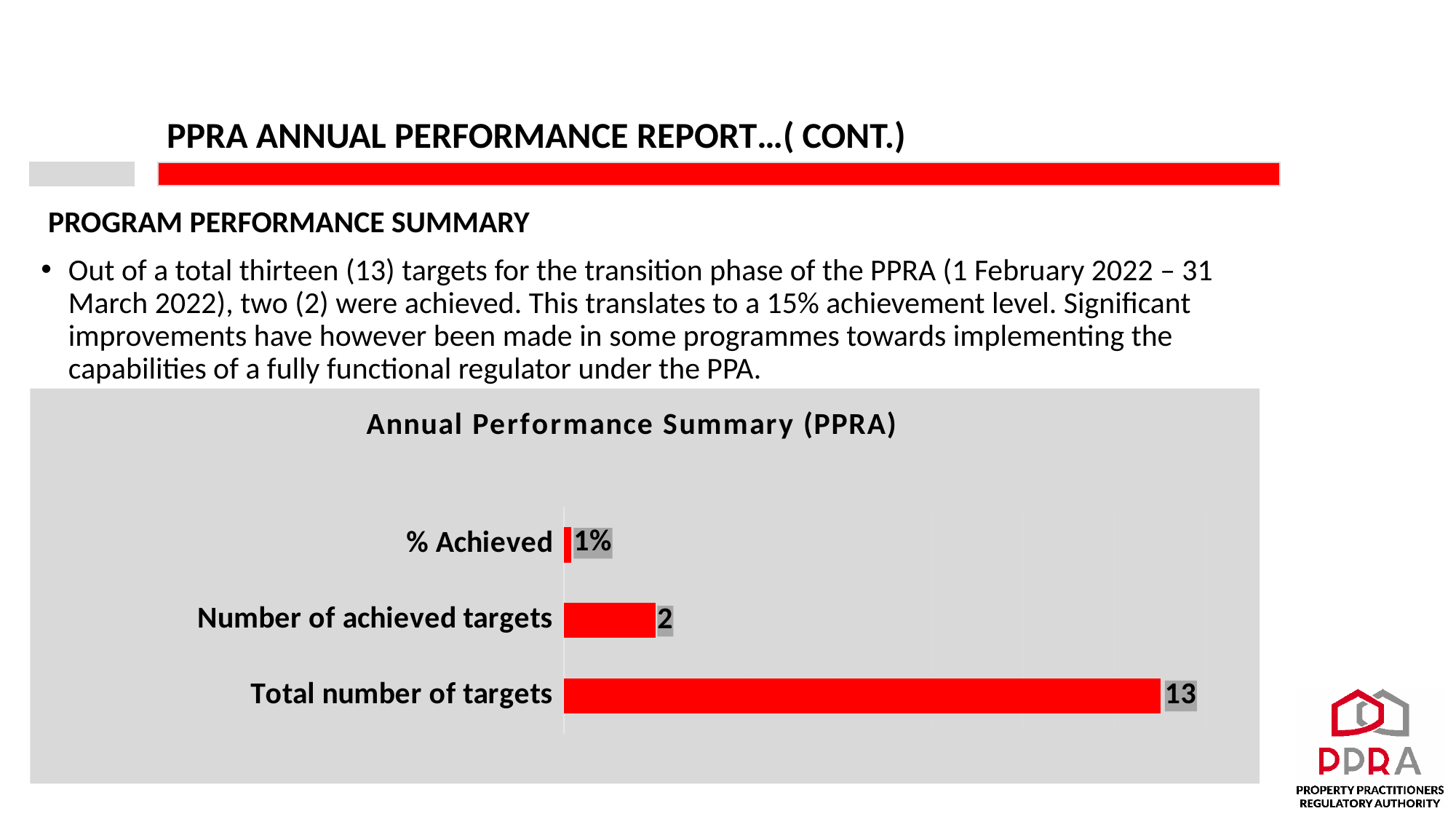
What is the value for Number of achieved targets in the chart? 2 Which is larger, Total number of targets or Number of achieved targets? Total number of targets What kind of chart is the Annual Performance Summary (PPRA)? Bar chart What is the value for Total number of targets in the Annual Performance Summary (PPRA) chart? 13 What data label is shown for % Achieved in the chart? 1% What is the title of the chart on the slide? Annual Performance Summary (PPRA) What is the difference between Total number of targets and Number of achieved targets? 11 Which category has the lowest value in the chart? % Achieved How many categories are shown in the Annual Performance Summary (PPRA) chart? 3 Which category has the highest value in the Annual Performance Summary (PPRA) chart? Total number of targets What colour are the bars in the chart? Red